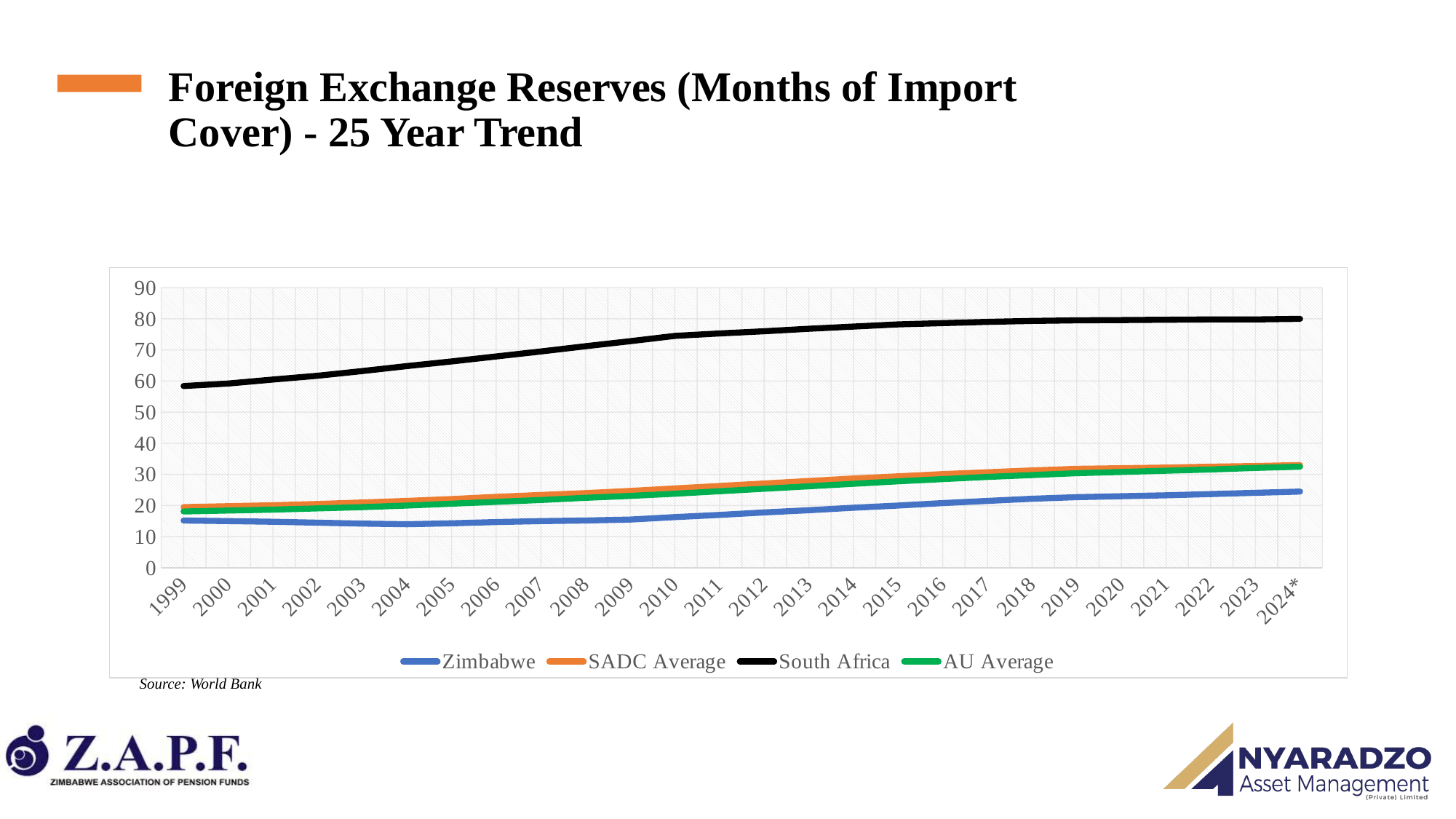
Which is larger in 2010, the value for South Africa or the value for Zimbabwe? South Africa Which series has the lowest value in 2005? Zimbabwe Is the value for South Africa in 1999 greater or less than 50? greater Which series has the highest value in 2015? South Africa Which series is drawn in black? South Africa How many series does the legend list? 4 What is the title of the chart? Foreign Exchange Reserves (Months of Import Cover) - 25 Year Trend Is the value for South Africa in 2024* greater or less than 70? greater How many years are shown along the x axis? 26 What kind of chart is shown on the slide? line chart Does the South Africa line rise or fall from 1999 to 2024*? rise Is the value for Zimbabwe in 2024* greater or less than 30? less